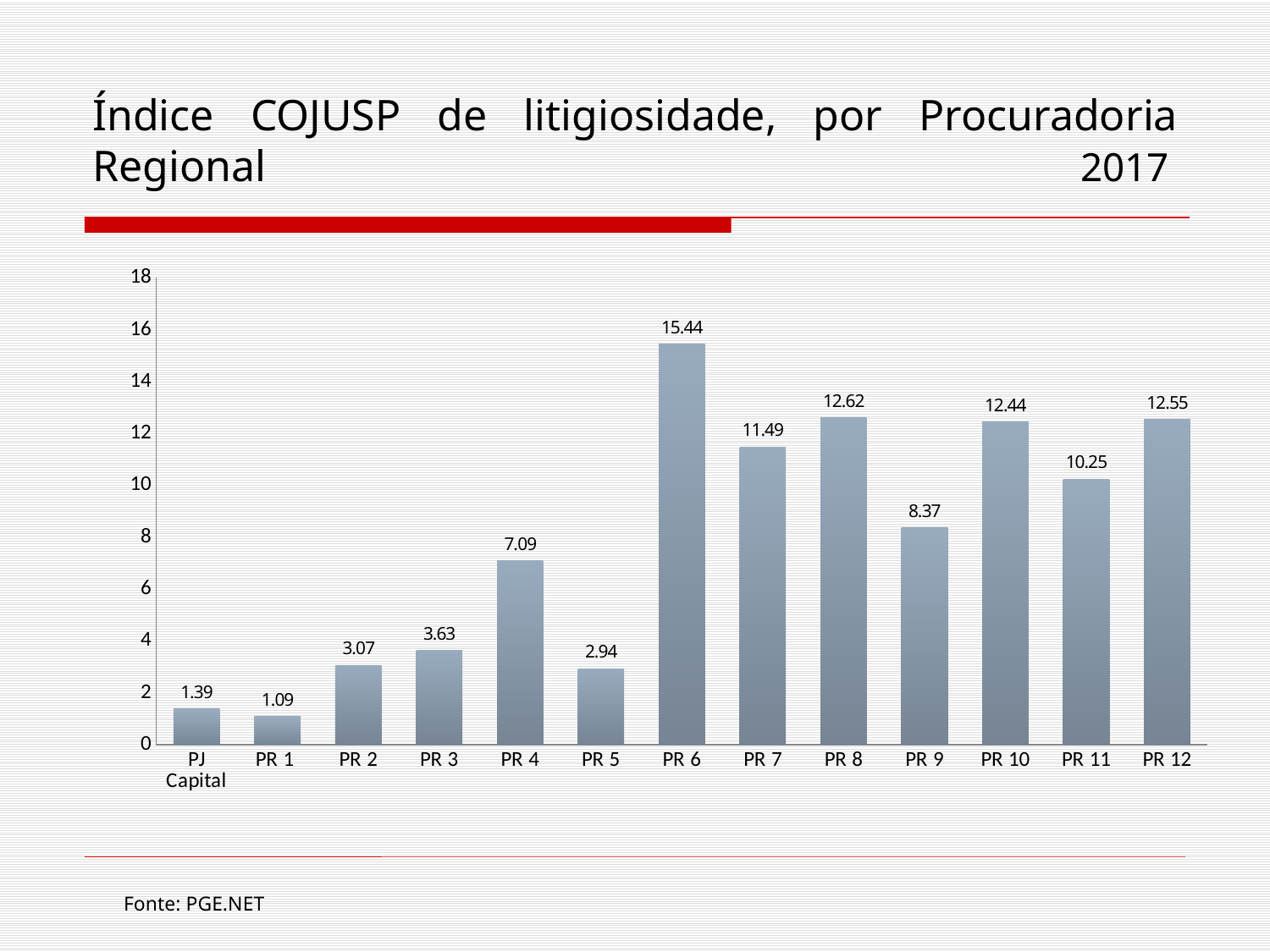
What source is cited below the chart? PGE.NET Which is larger, the value for PR 8 or the value for PR 11? PR 8 Is the value for PR 10 greater or less than 12? greater What is the value for PR 9? 8.37 How many categories are shown on the x axis? 13 What is the difference between the values for PR 6 and PR 7? 3.95 What is the value for PR 6? 15.44 What kind of chart is shown on the slide? bar chart What is the difference between the values for PR 4 and PR 5? 4.15 What is the value for PJ Capital? 1.39 Which category has the lowest value? PR 1 Which category has the highest value? PR 6